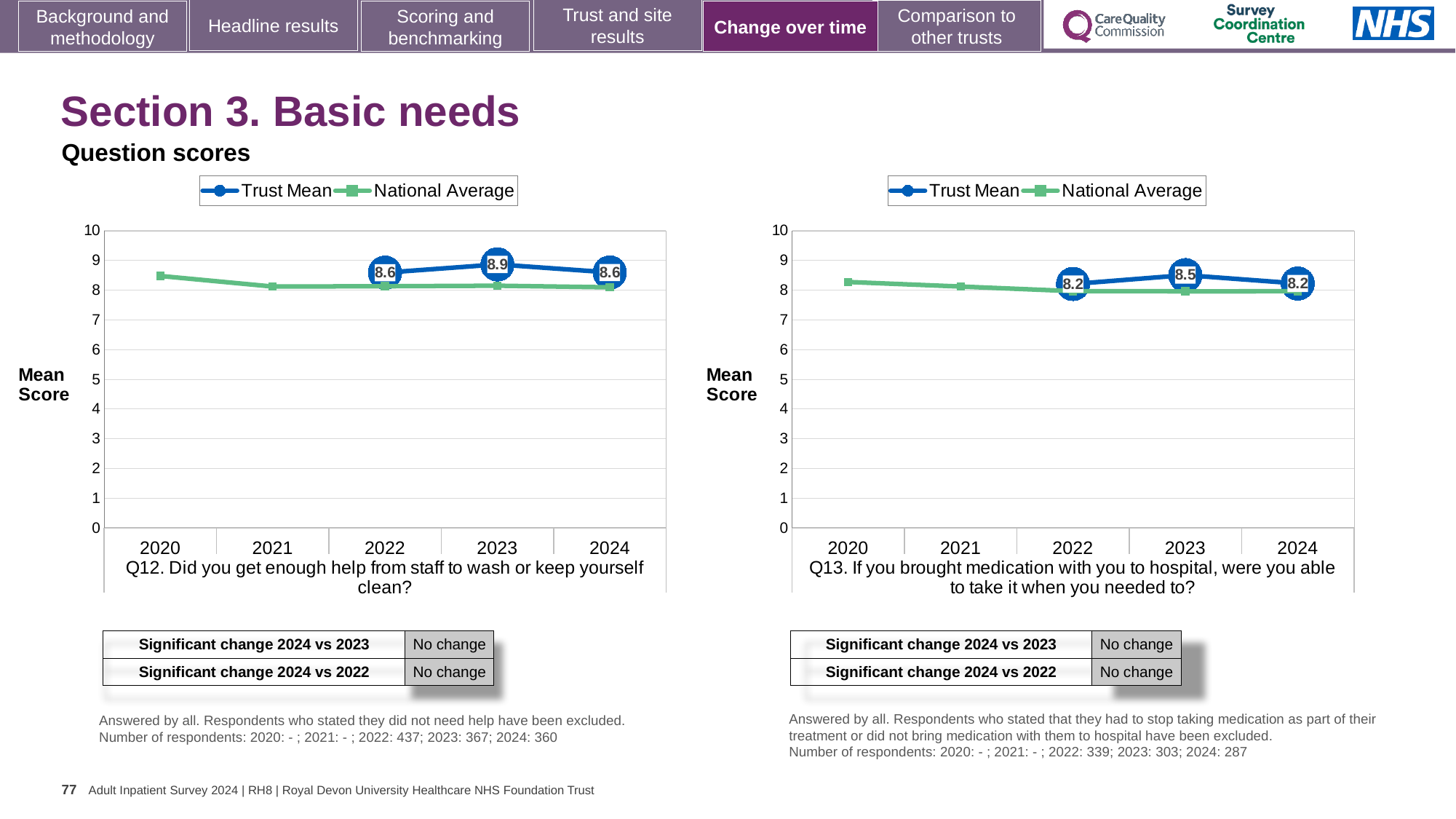
In the Q12 chart (left), which year has the highest Trust Mean? 2023 In the Q13 chart (right), what is the Trust Mean for 2023? 8.5 In the Q13 chart (right), what is the Trust Mean for 2022? 8.2 In the Q12 chart (left), what is the Trust Mean for 2024? 8.6 In the Q12 chart (left), what is the Trust Mean for 2023? 8.9 In the Q12 chart (left), what is the difference between the Trust Mean for 2023 and 2024? 0.3 What kind of chart is the Q13 chart (right)? Line chart In the Q13 chart (right), is the National Average for 2020 greater or less than 9? less In the Q12 chart (left), is the Trust Mean for 2023 greater or less than 8? greater How many series does the legend of the Q12 chart (left) list? 2 In the Q13 chart (right), what is the difference between the Trust Mean for 2023 and 2022? 0.3 In the Q13 chart (right), which year has the highest Trust Mean? 2023